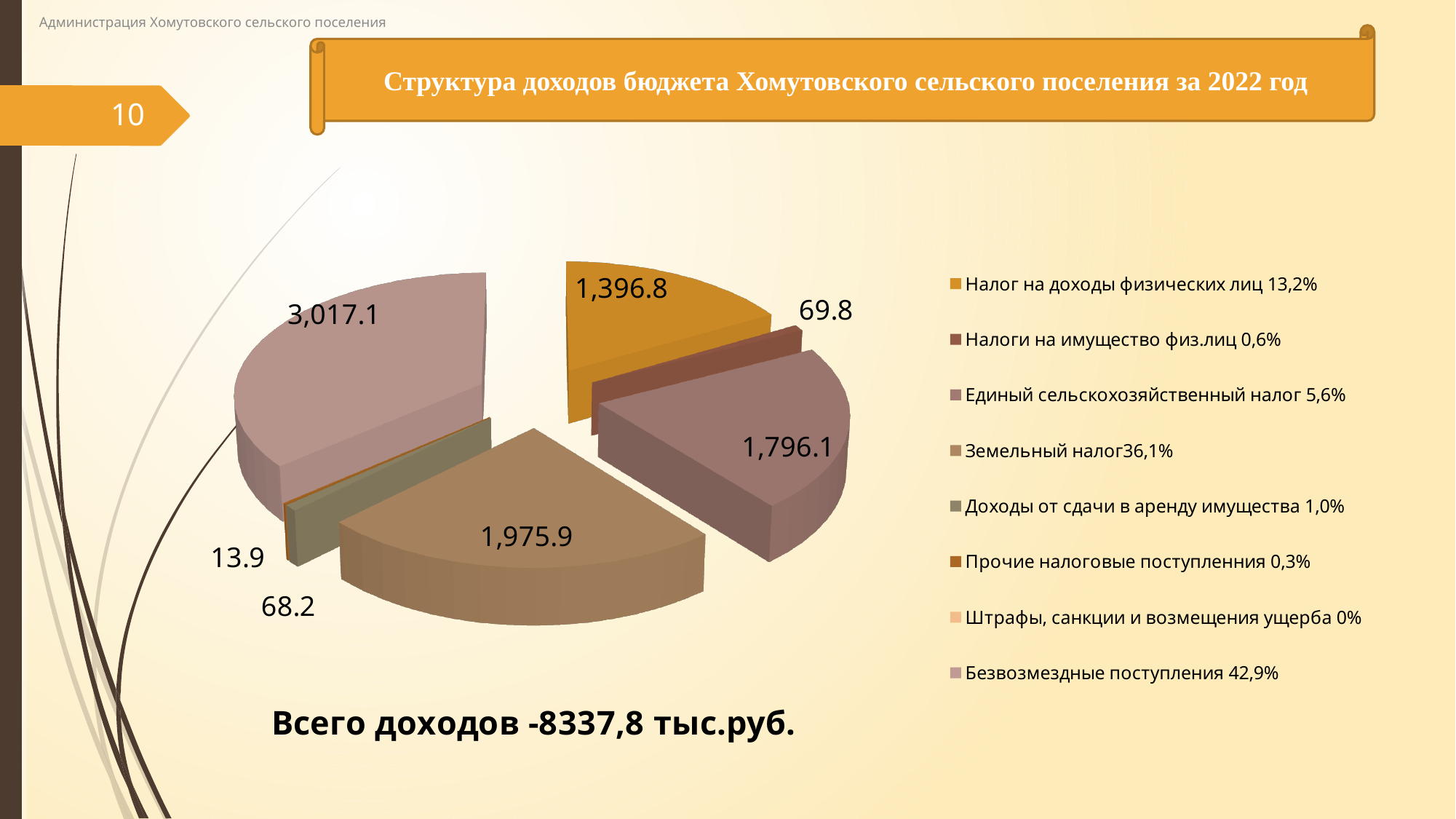
Which is larger: the slice for Земельный налог or the slice for Единый сельскохозяйственный налог? Земельный налог What total income is stated below the chart? 8337,8 тыс.руб. What kind of chart is shown on the slide? pie chart What is the value of the slice for Доходы от сдачи в аренду имущества? 68.2 What is the difference between the slice labelled 3,017.1 and the slice labelled 1,975.9? 1,041.2 What is the value of the slice for Безвозмездные поступления? 3,017.1 Which category has the largest slice in the pie chart? Безвозмездные поступления What is the value of the slice for Налоги на имущество физ.лиц? 69.8 What percentage does the legend give for Безвозмездные поступления? 42,9% How many entries does the legend list? 8 What is the value of the slice for Налог на доходы физических лиц? 1,396.8 What is the value of the slice for Земельный налог? 1,975.9